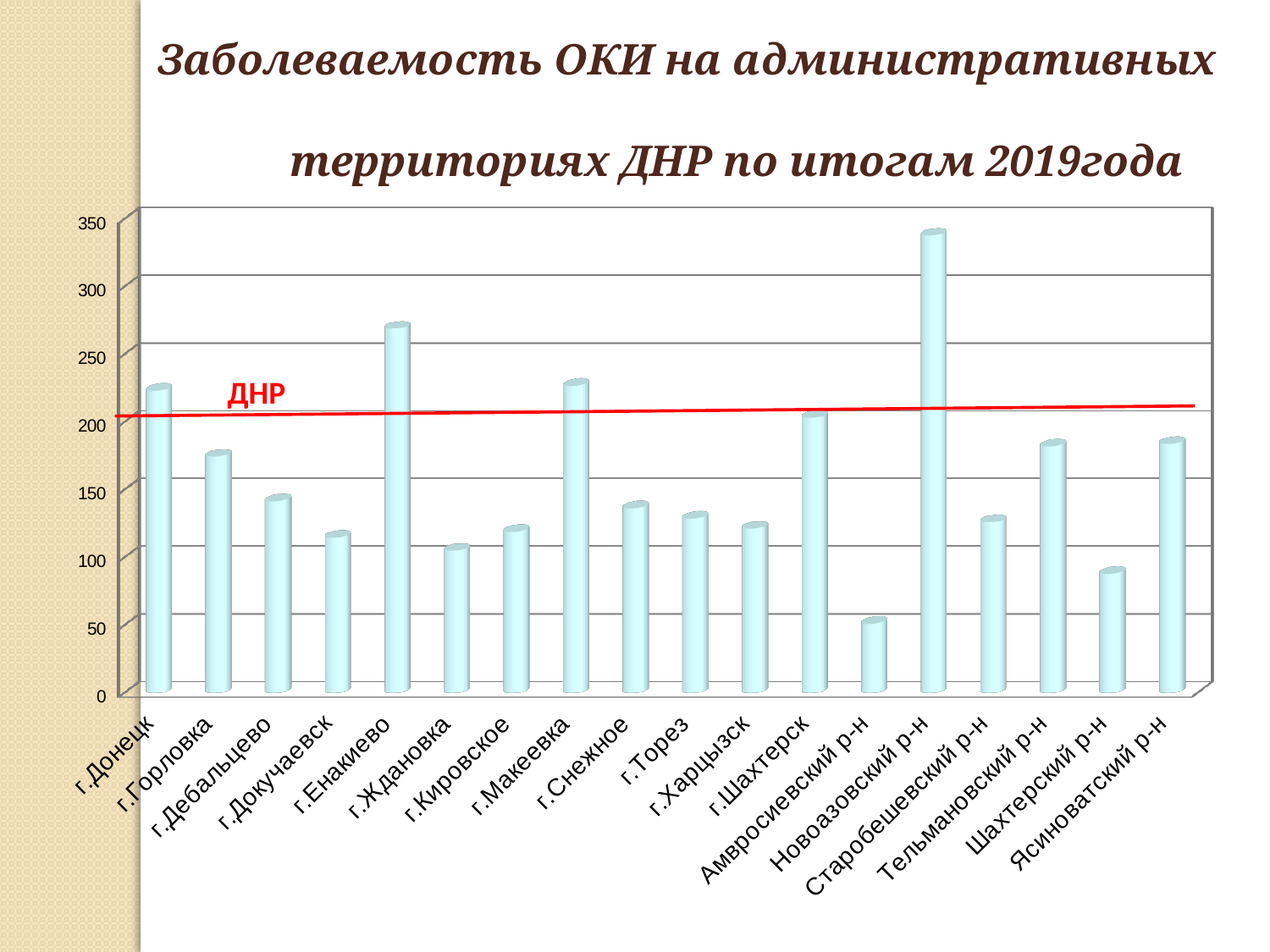
Is the value for г.Снежное greater or less than 150? less What label is written on the red horizontal line across the chart? ДНР Which territory has the highest value on the chart? Новоазовский р-н Is the value for Новоазовский р-н greater or less than 300? greater Which has the larger value, г.Енакиево or г.Макеевка? г.Енакиево Which has the larger value, г.Донецк or г.Горловка? г.Донецк Is the value for г.Енакиево greater or less than 250? greater How many administrative territories (categories) are plotted on the chart? 18 Which territory has the lowest value on the chart? Амвросиевский р-н What kind of chart is shown on the slide? bar chart